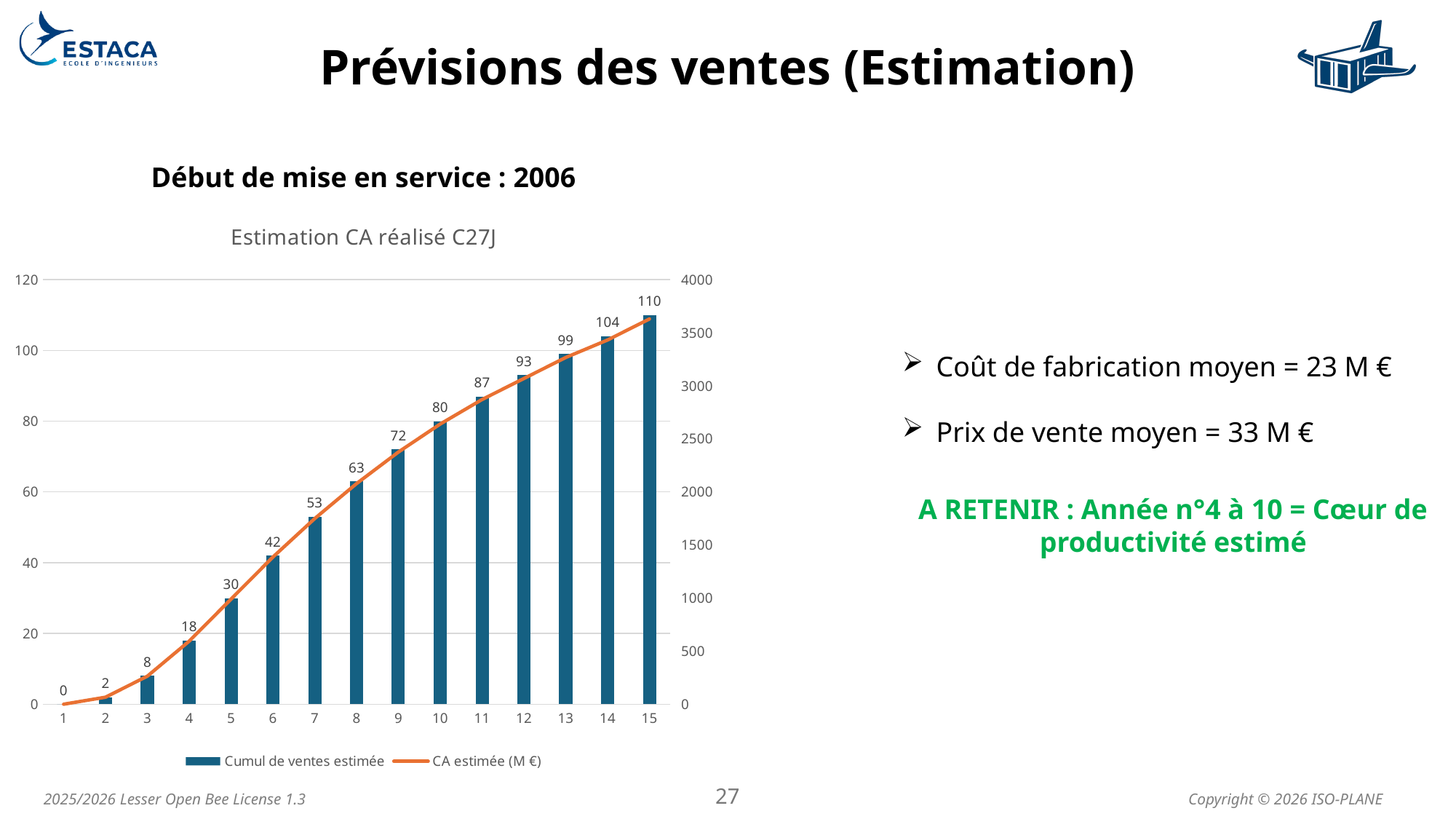
What is the difference in 'Cumul de ventes estimée' between year 15 and year 10? 30 What is the value of 'Cumul de ventes estimée' for year 10? 80 How many years (categories) are shown on the x axis? 15 What type of chart is shown on the slide? Combined bar and line chart Which is larger, the 'Cumul de ventes estimée' for year 7 or for year 9? Year 9 Which year has the lowest 'Cumul de ventes estimée'? 1 How many series does the legend list? 2 Which year has the highest 'Cumul de ventes estimée'? 15 Does the 'Cumul de ventes estimée' rise or fall from year 1 to year 15? Rises What is the title of the chart? Estimation CA réalisé C27J Is the 'CA estimée (M €)' value for year 13 greater or less than 3000? greater What is the value of 'Cumul de ventes estimée' for year 4? 18